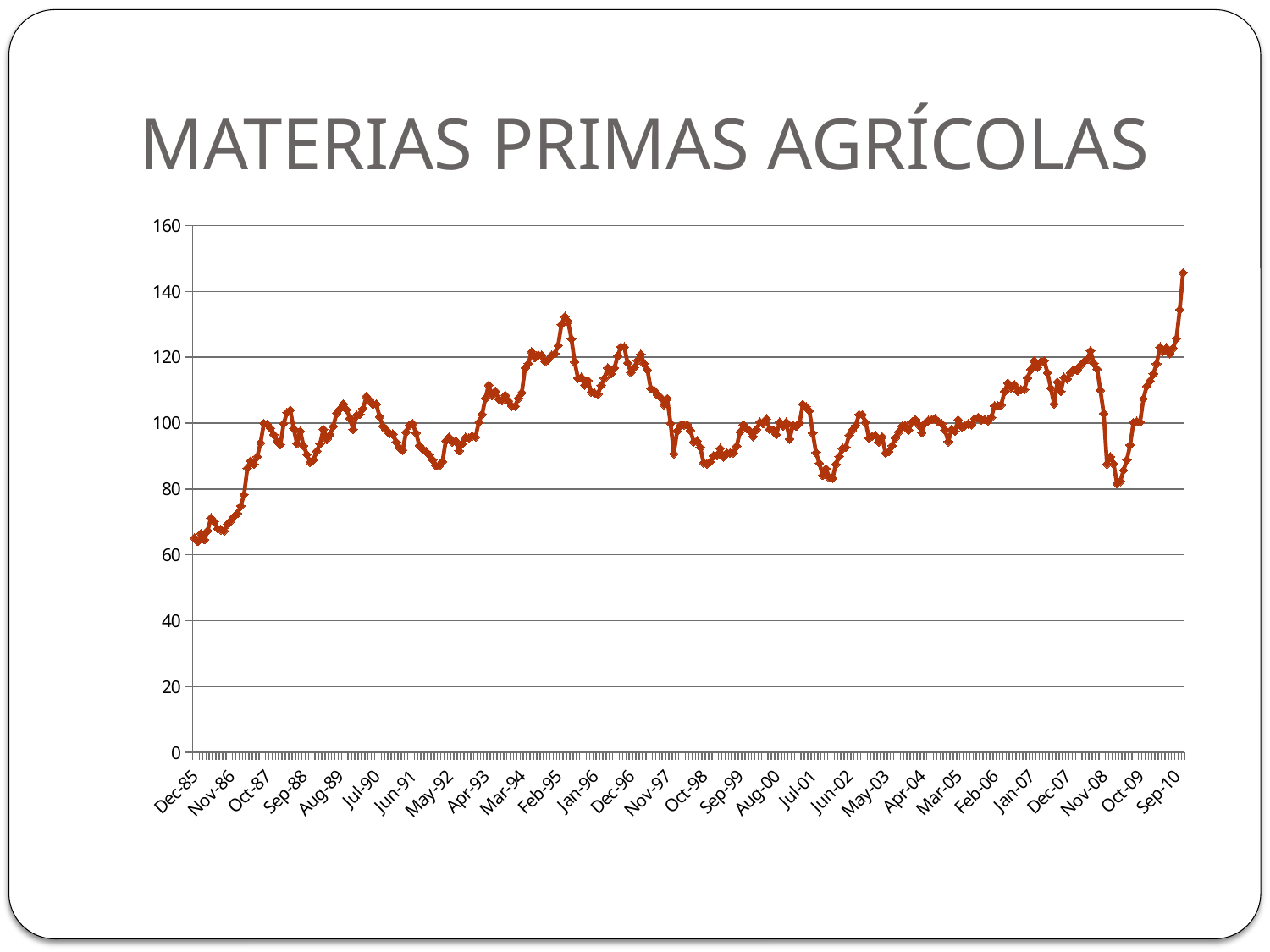
What kind of chart is shown on the slide? line chart Do the values rise or fall from Feb-95 to Nov-97? fall What is the title of the chart? MATERIAS PRIMAS AGRÍCOLAS What is the highest value shown on the vertical axis? 160 Is the value for Jan-07 greater or less than 100? greater Is the value for Sep-10 greater or less than 120? greater Do the values rise or fall from Dec-85 to Oct-87? rise Is the value for Feb-95 greater or less than 120? greater Overall, do the values rise or fall from Dec-85 to Sep-10? rise